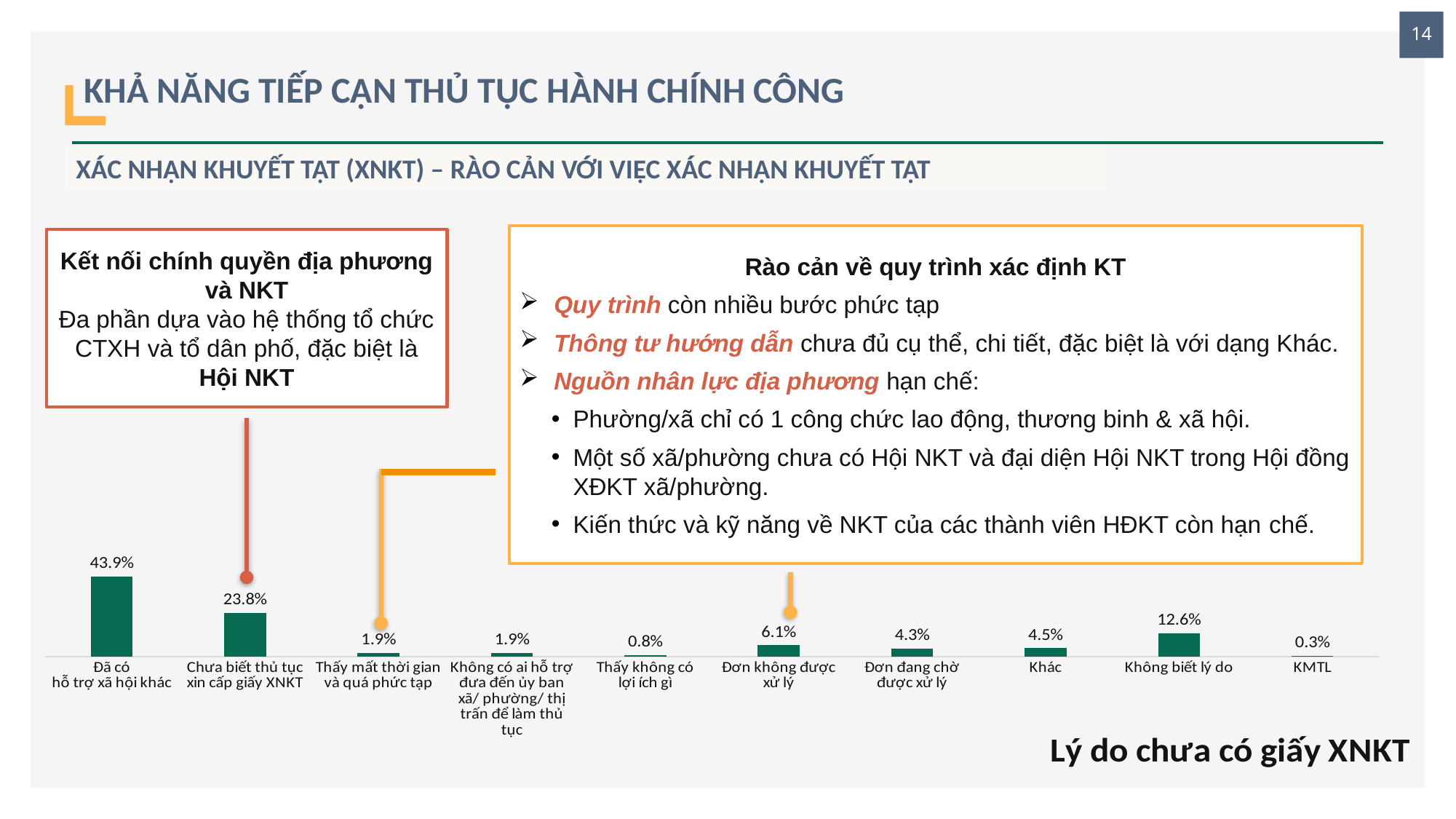
Which category has the highest value? Đã có hỗ trợ xã hội khác How many categories are shown in the chart? 10 What is the value for "Đơn không được xử lý"? 6.1% What is the value for "KMTL"? 0.3% Which category has the lowest value? KMTL What is the difference between "Đã có hỗ trợ xã hội khác" and "Chưa biết thủ tục xin cấp giấy XNKT"? 20.1% What kind of chart is shown on the slide? Bar chart What is the title of the chart? Lý do chưa có giấy XNKT What is the value for "Không biết lý do"? 12.6% What is the value for "Đã có hỗ trợ xã hội khác"? 43.9% Which is larger, "Đơn không được xử lý" or "Đơn đang chờ được xử lý"? Đơn không được xử lý What is the value for "Chưa biết thủ tục xin cấp giấy XNKT"? 23.8%